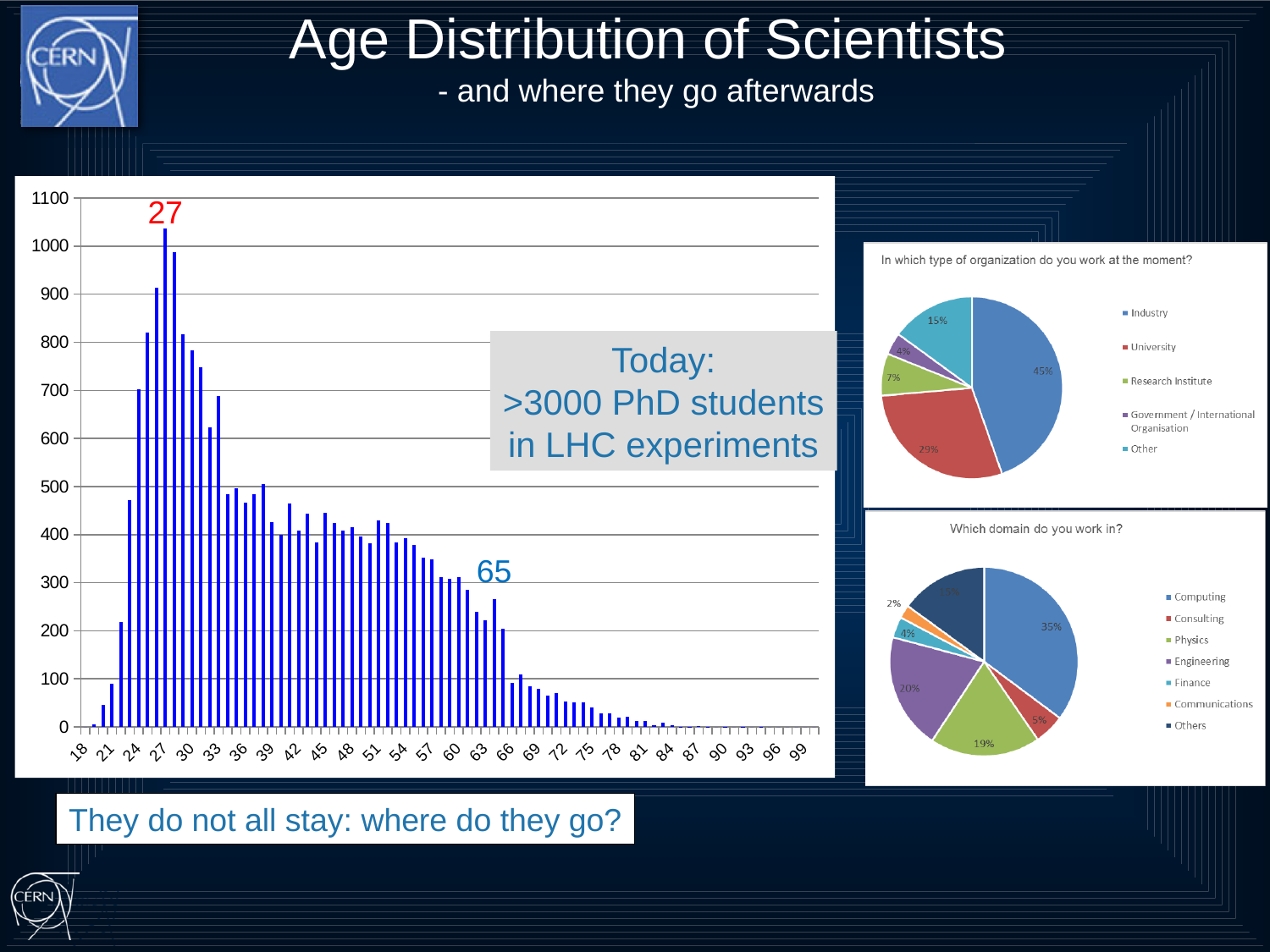
In the age distribution bar chart, is the value for age 27 greater or less than 900? greater In the pie chart 'In which type of organization do you work at the moment?', what share is Industry? 45% In the pie chart 'Which domain do you work in?', what share is Computing? 35% In the pie chart 'In which type of organization do you work at the moment?', how many categories does the legend list? 5 In the age distribution bar chart, is the value for age 65 greater or less than 300? less In the age distribution bar chart, which age is annotated as the peak of the distribution? 27 What type of chart is the large chart on the left showing the age distribution? bar chart In the age distribution bar chart, do the values rise or fall as age increases from 27 to 99? fall In the pie chart 'In which type of organization do you work at the moment?', which category has the smallest share? Government / International Organisation In the pie chart 'In which type of organization do you work at the moment?', what share is University? 29% In the pie chart 'Which domain do you work in?', what is the difference between the Engineering share and the Physics share? 1% In the age distribution bar chart, is the value for age 24 greater or less than 600? greater